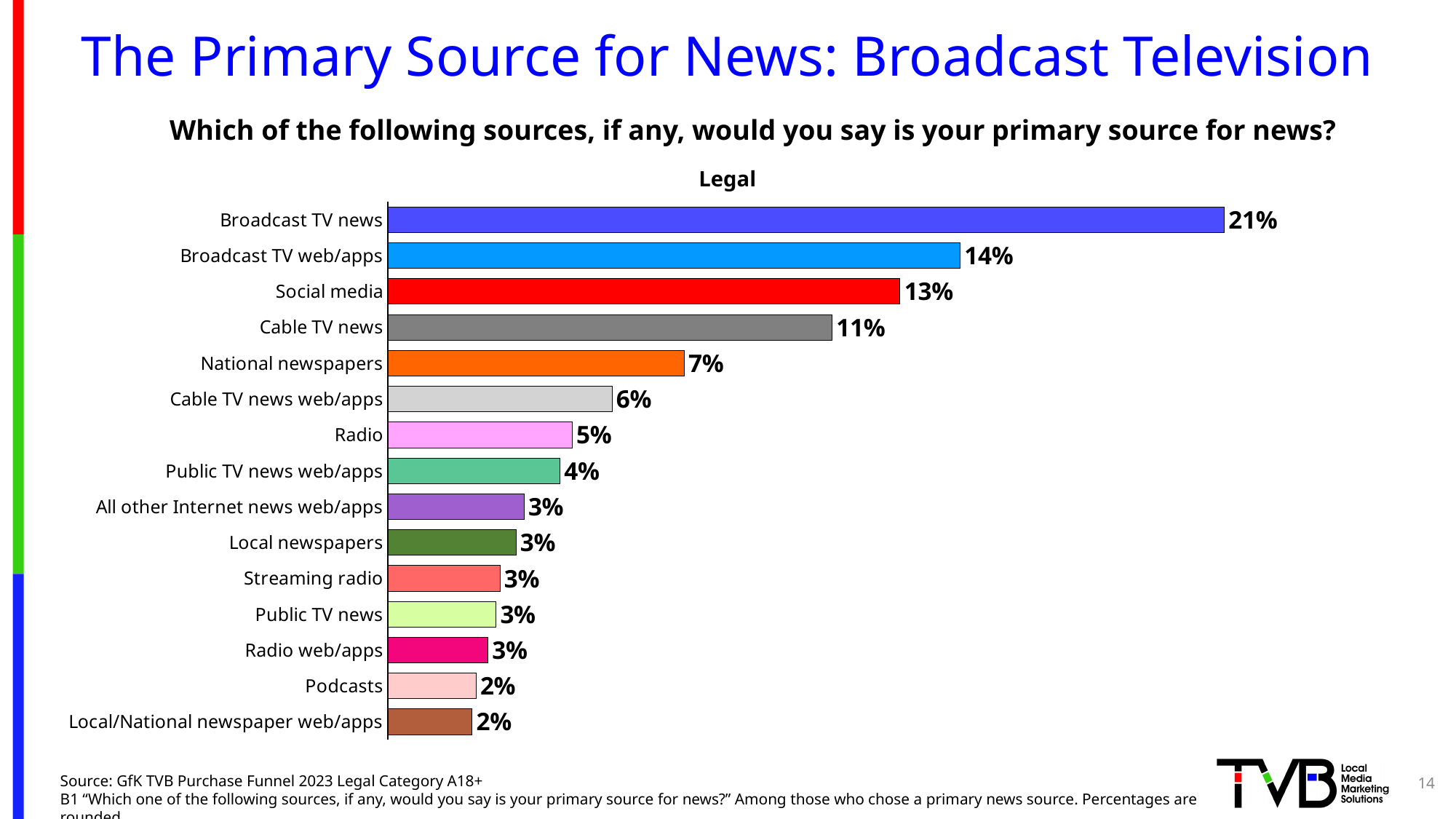
What is the value shown for Social media? 13% Which has a larger value, Social media or Cable TV news? Social media What is the difference between the values for Broadcast TV news and Broadcast TV web/apps? 7% Which source has the highest percentage in the chart? Broadcast TV news What is the difference between the values for Cable TV news and National newspapers? 4% Which has a larger value, Radio or Public TV news web/apps? Radio How many news sources (categories) are shown in the chart? 15 What percentage of respondents named Broadcast TV news as their primary source for news? 21% What is the value shown for Podcasts? 2% What is the value shown for Cable TV news web/apps? 6% What is the title printed directly above the chart? Legal What type of chart is shown on the slide? Bar chart